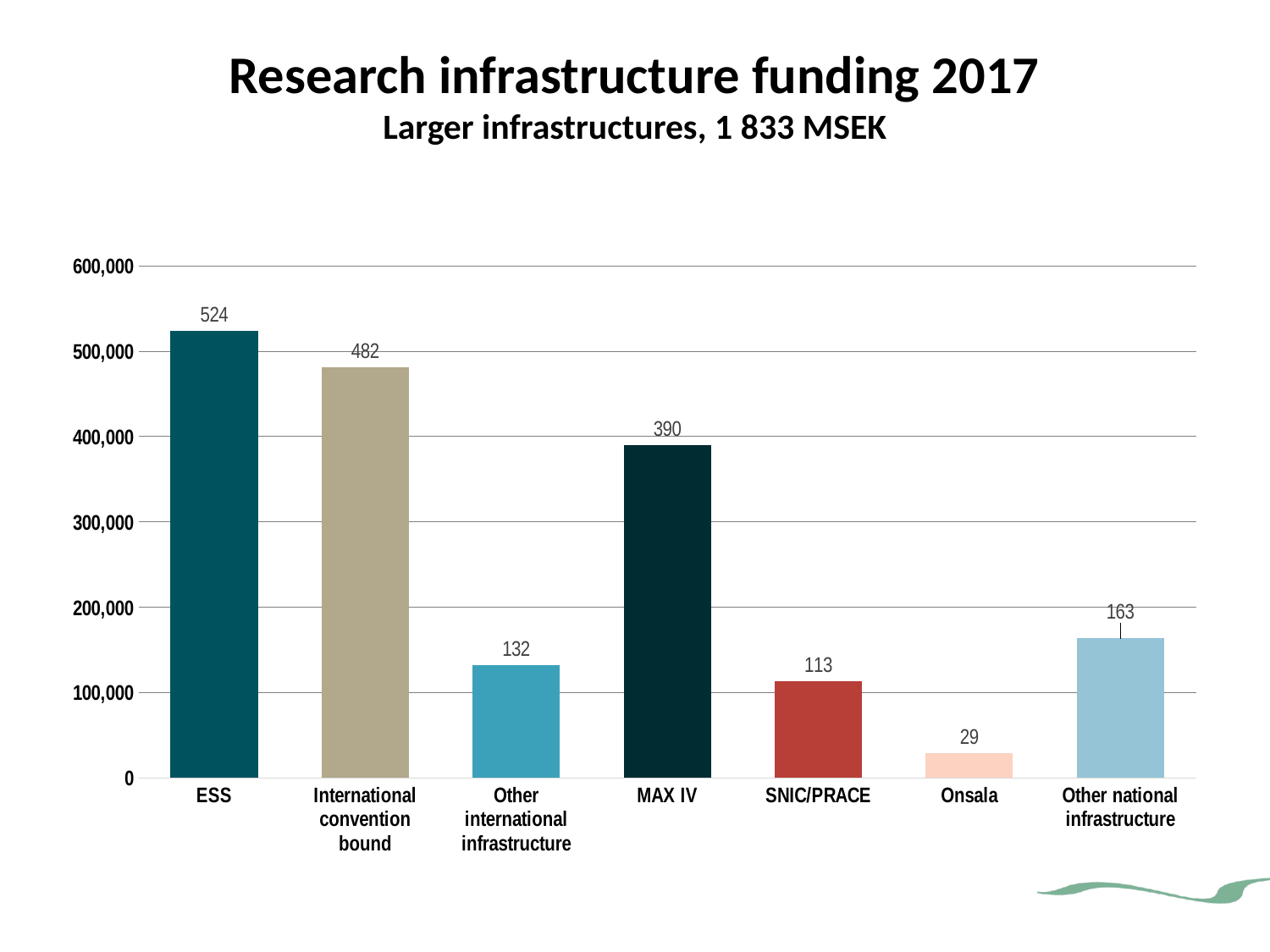
Which category has the highest value? ESS What is the difference between the data labels for ESS and International convention bound? 42 Which category has the lowest value? Onsala What is the subtitle of the chart? Larger infrastructures, 1 833 MSEK What is the data label shown for MAX IV? 390 Which is larger, the value for SNIC/PRACE or the value for Other international infrastructure? Other international infrastructure What is the data label shown for Onsala? 29 What is the data label shown for Other national infrastructure? 163 How many categories are shown on the x axis? 7 What kind of chart is shown on the slide? bar chart Is the value for MAX IV greater or less than 400,000 on the axis? less What is the data label shown for ESS? 524